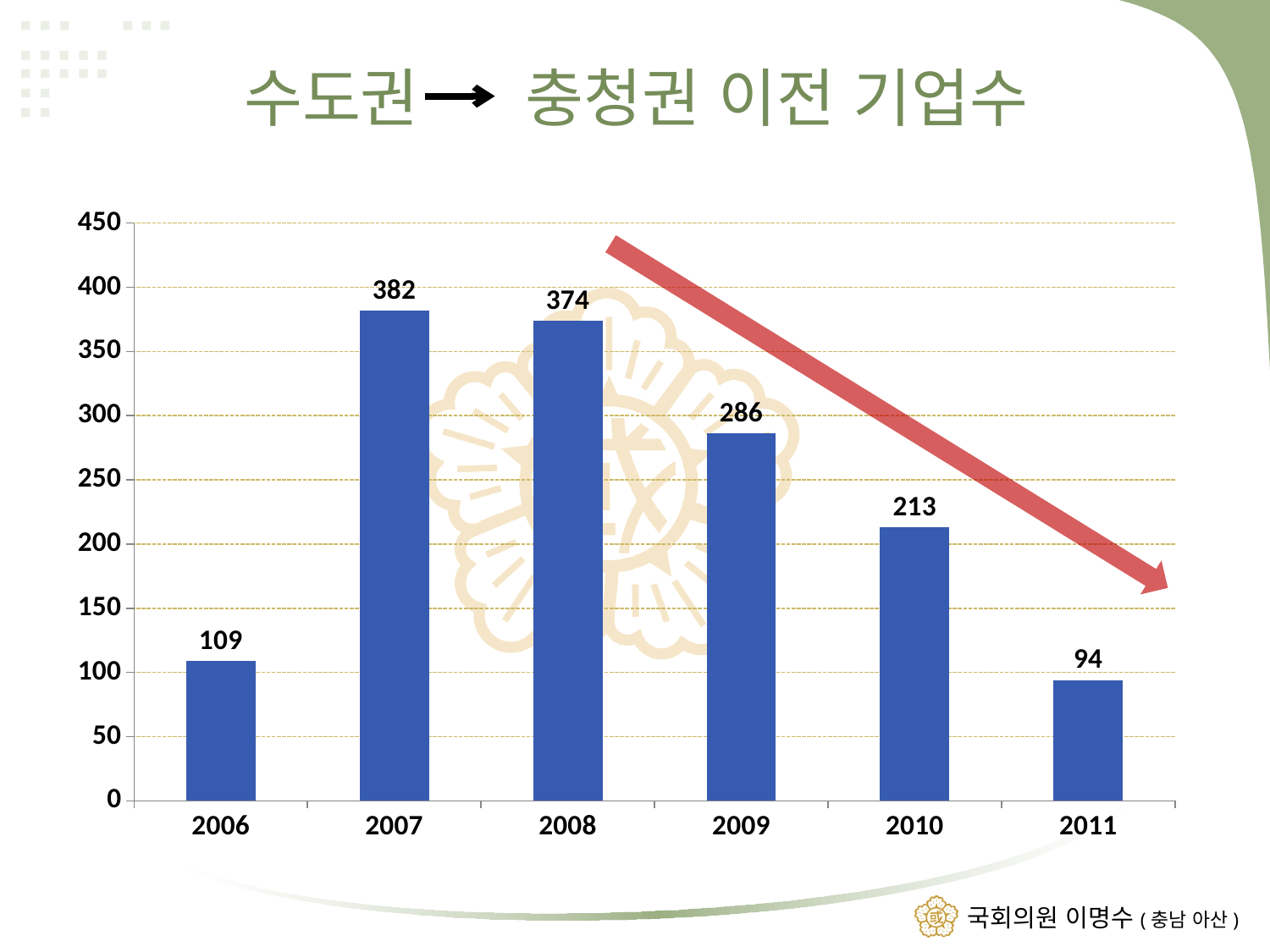
Which is larger, the value for 2009 or the value for 2010? 2009 What is the value for 2007? 382 Which year has the lowest value? 2011 What is the difference between the values for 2006 and 2011? 15 Which year has the highest value? 2007 What is the difference between the values for 2007 and 2008? 8 How many years are shown on the x axis? 6 Do the values rise or fall from 2007 to 2011? fall What kind of chart is shown on the slide? bar chart Is the value for 2010 greater or less than 200? greater What is the value for 2009? 286 What is the value for 2011? 94